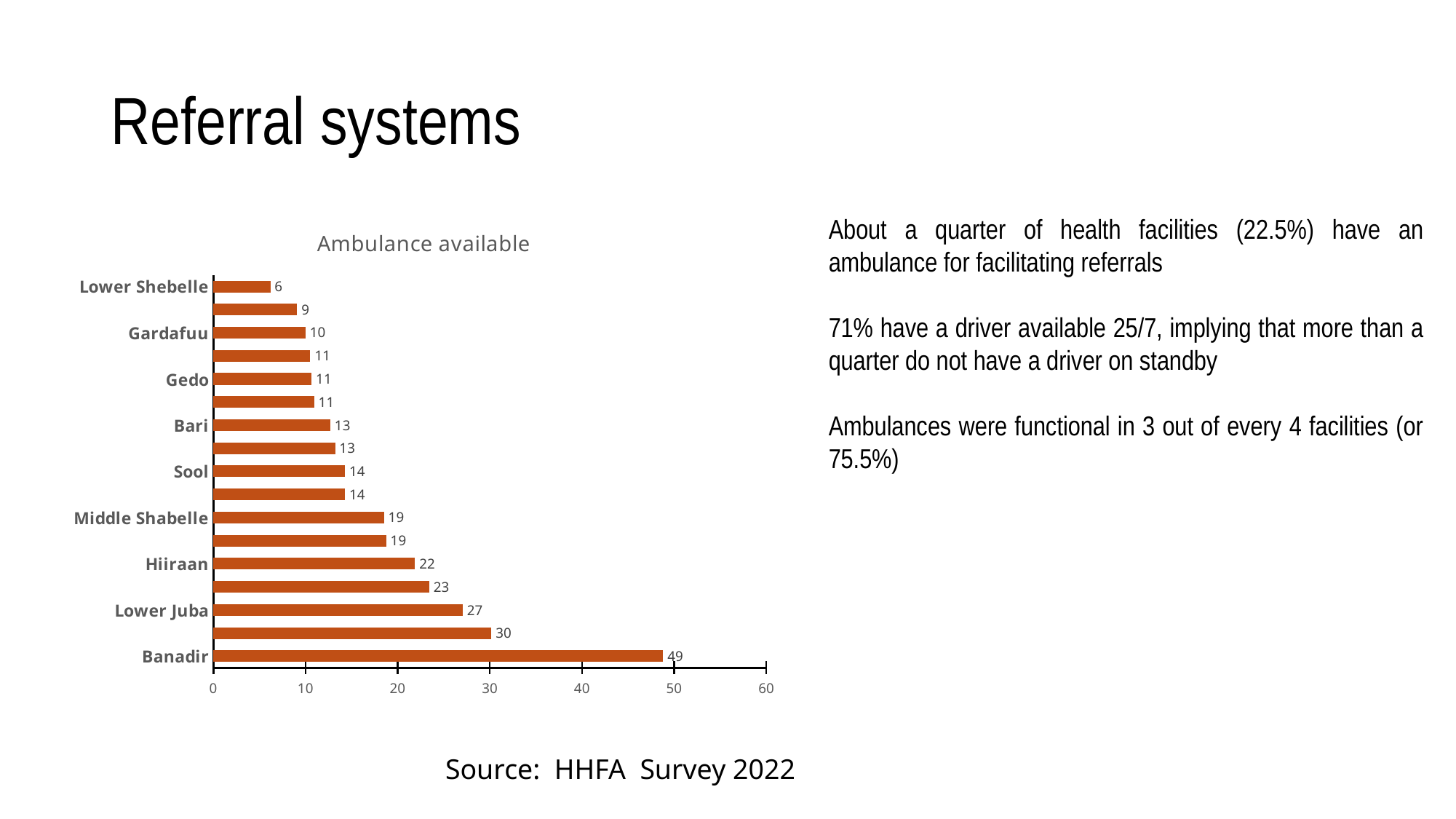
What is the value for Lower Shebelle in the Ambulance available chart? 6 How many bars are plotted in the Ambulance available chart? 17 Is the value for Lower Juba in the Ambulance available chart greater or less than 20? greater What is the title of the chart on the slide? Ambulance available Which labelled region has the lowest value in the Ambulance available chart? Lower Shebelle What is the value for Banadir in the Ambulance available chart? 49 What kind of chart is shown on the slide? bar chart Which has a larger value in the Ambulance available chart, Middle Shabelle or Sool? Middle Shabelle What is the value for Gedo in the Ambulance available chart? 11 Which labelled region has the highest value in the Ambulance available chart? Banadir What is the value for Hiiraan in the Ambulance available chart? 22 What is the difference between the values for Banadir and Lower Juba in the Ambulance available chart? 22